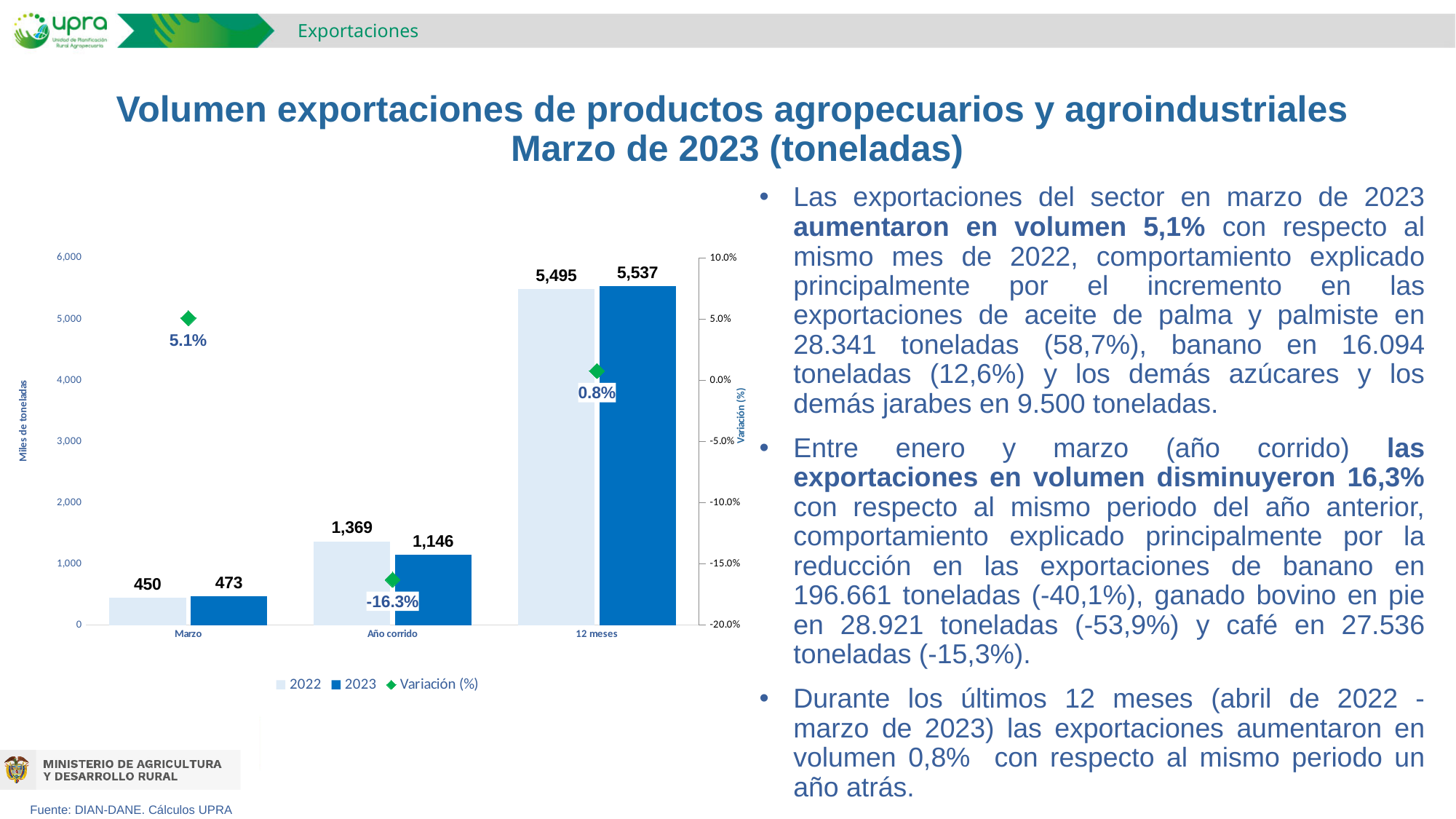
What is the Variación (%) value for 12 meses? 0.8% What kind of chart is used for the 2022 and 2023 series? Bar chart What is the label of the left vertical axis? Miles de toneladas What is the Variación (%) value for Año corrido? -16.3% What is the 2023 value for Año corrido? 1,146 Which category has the lowest 2022 value? Marzo Which category has the highest 2023 value? 12 meses How many series does the legend list? 3 What is the difference between the 2023 and 2022 values for 12 meses? 42 How many categories are shown on the x axis? 3 What is the 2022 value for Marzo? 450 Which is larger for Año corrido, the 2022 value or the 2023 value? 2022